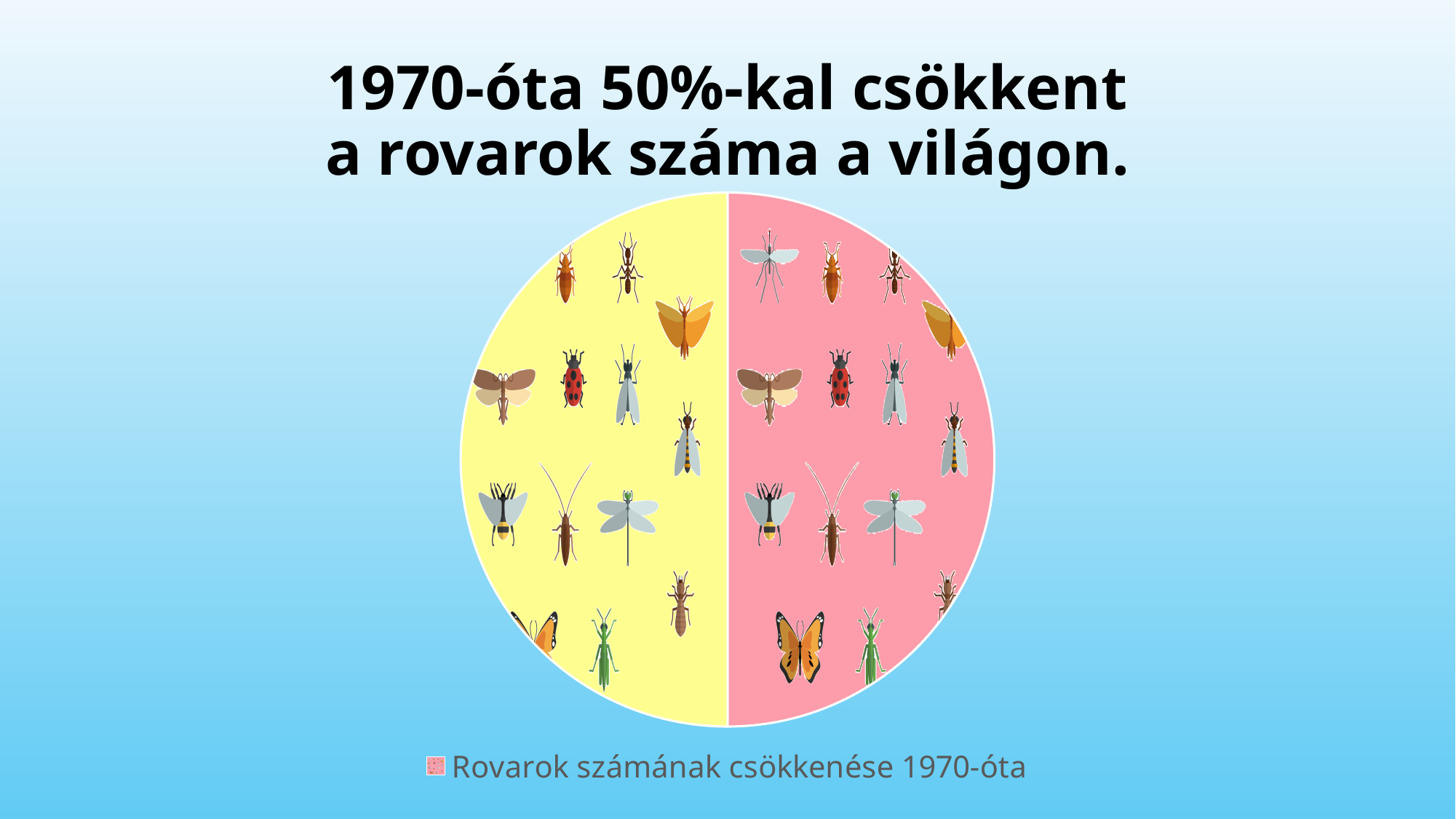
How many entries does the legend of the pie chart list? 1 What share of the pie does the pink slice "Rovarok számának csökkenése 1970-óta" represent? 50% What colour is the slice labelled "Rovarok számának csökkenése 1970-óta" in the legend? pink What kind of chart is shown on the slide? pie chart What is the title of the slide above the pie chart? 1970-óta 50%-kal csökkent a rovarok száma a világon. How many slices does the pie chart have? 2 By what percentage has the number of insects in the world decreased since 1970, according to the slide? 50% Since which year does the chart show the decline in the number of insects? 1970 What is the legend entry shown below the pie chart? Rovarok számának csökkenése 1970-óta